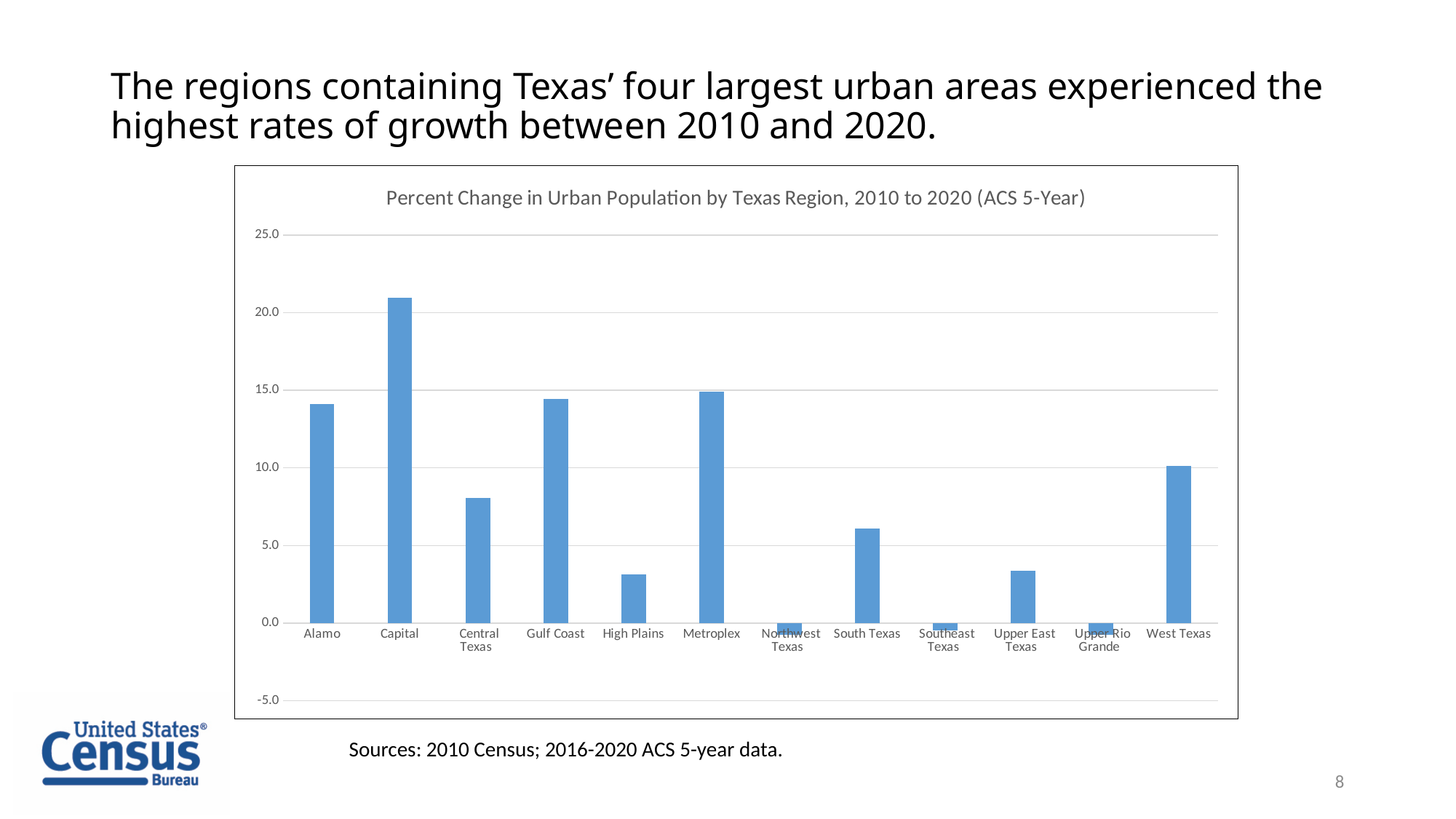
Which region has the highest percent change in urban population? Capital How many Texas regions are shown on the x axis of the chart? 12 Is the value for Alamo greater or less than 15.0? less Is the value for South Texas greater or less than 5.0? greater Which is larger, the value for West Texas or the value for Central Texas? West Texas Which is larger, the value for Capital or the value for Metroplex? Capital Is the value for Central Texas greater or less than 10.0? less How many regions show a negative percent change in urban population? 3 What is the title of the chart? Percent Change in Urban Population by Texas Region, 2010 to 2020 (ACS 5-Year) What kind of chart is shown on the slide? Bar chart